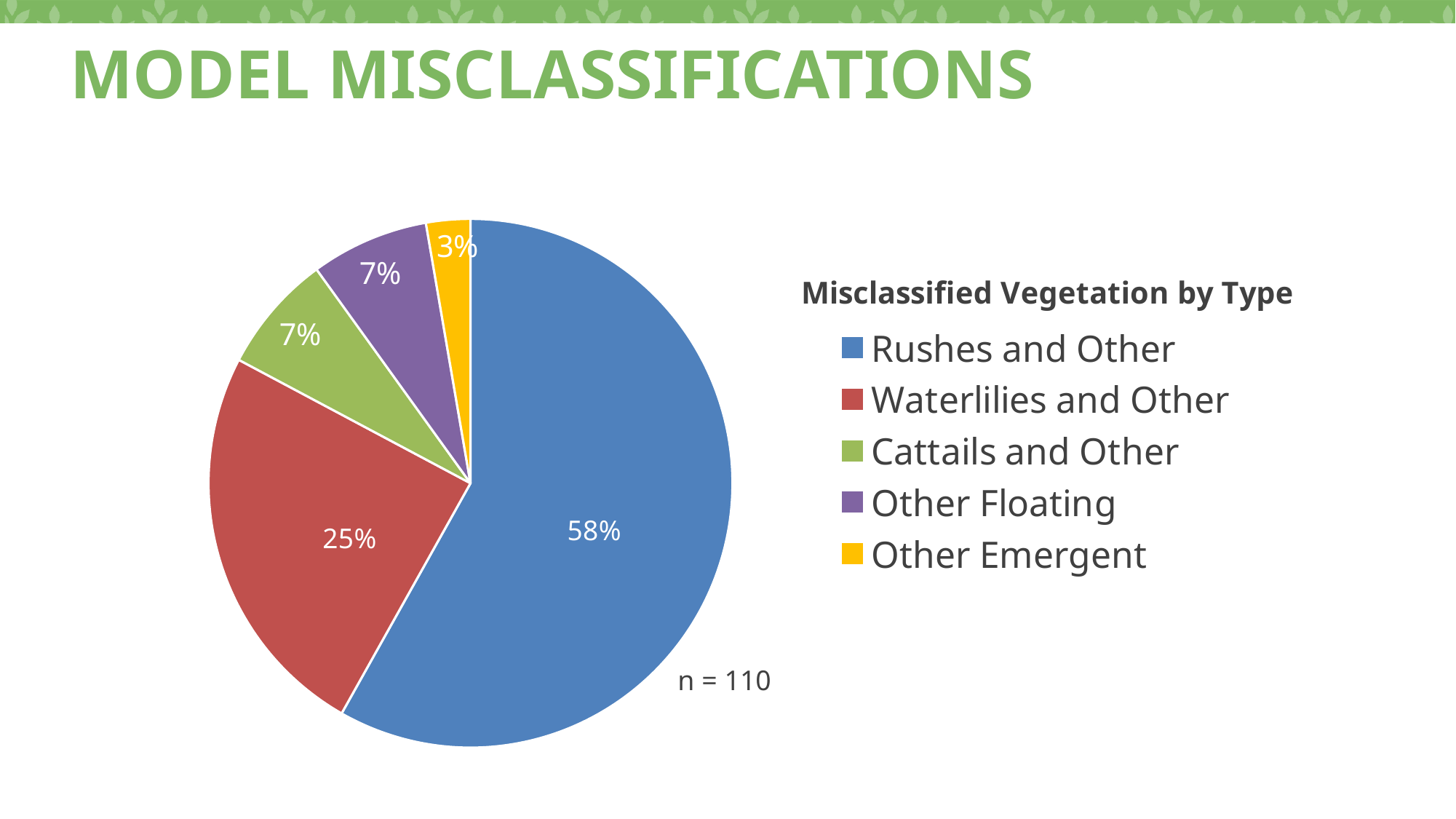
What share of the pie does Rushes and Other account for? 58% How many categories does the legend list? 5 Which category has the smallest slice of the pie? Other Emergent What share of the pie does Cattails and Other account for? 7% What is the difference in percentage points between Rushes and Other and Waterlilies and Other? 33 What sample size (n) is noted next to the pie chart? n = 110 Which category has the largest slice of the pie? Rushes and Other What kind of chart is shown on the slide? pie chart What is the title of the legend? Misclassified Vegetation by Type What share of the pie does Waterlilies and Other account for? 25% Which is larger, the share for Waterlilies and Other or the share for Other Floating? Waterlilies and Other